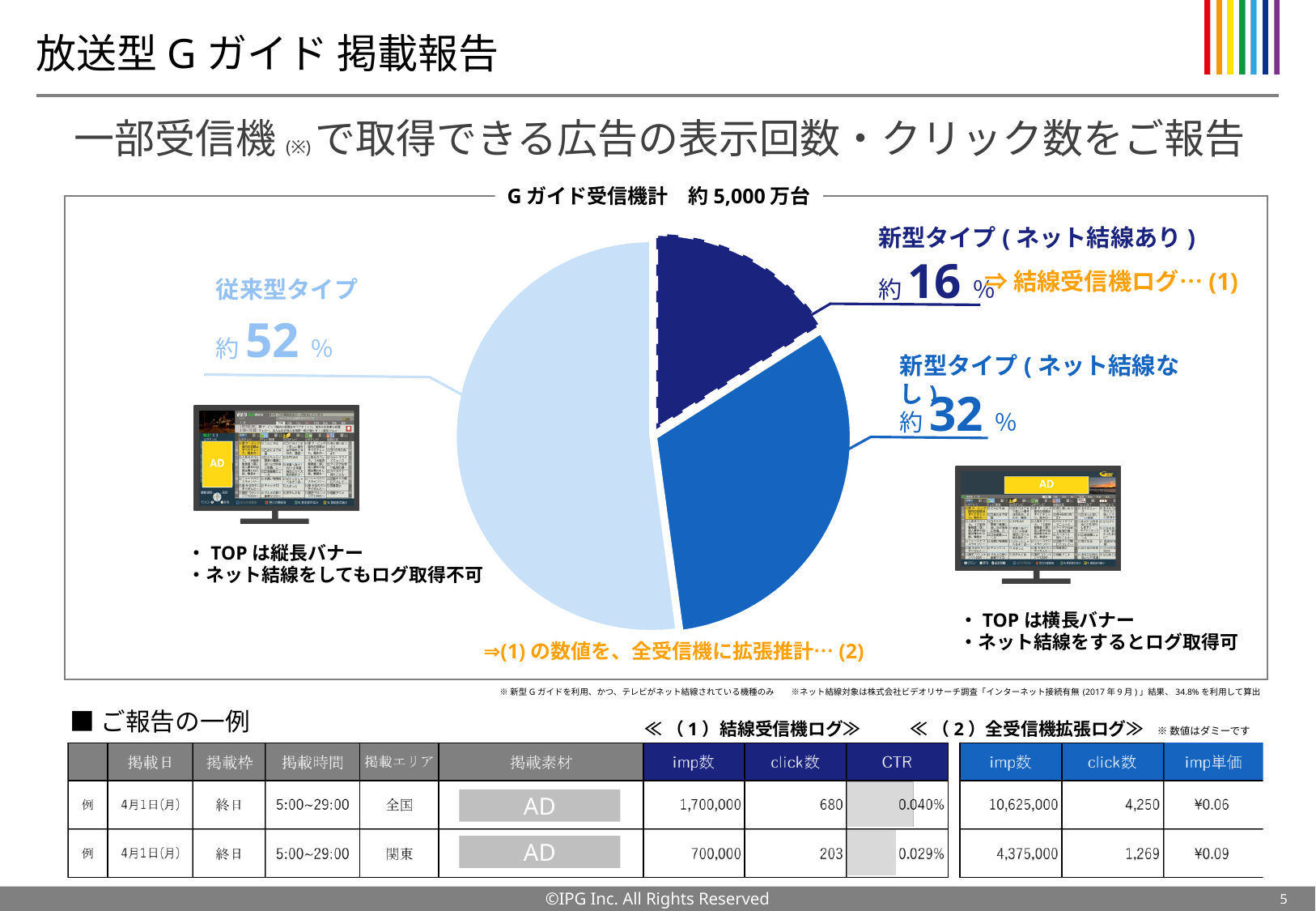
What kind of chart is shown on the slide? pie chart Which is larger, the share for 新型タイプ(ネット結線なし) or the share for 新型タイプ(ネット結線あり)? 新型タイプ(ネット結線なし) Which slice of the pie chart is drawn in the lightest blue? 従来型タイプ What share of the pie does 新型タイプ(ネット結線なし) account for? 約32% What share of the pie does 新型タイプ(ネット結線あり) account for? 約16% What is the total number of G guide receivers stated above the pie chart? 約5,000万台 How many slices does the pie chart have? 3 By how many percentage points does the 従来型タイプ share exceed the 新型タイプ(ネット結線あり) share? 36 Which slice of the pie chart is the smallest? 新型タイプ(ネット結線あり) Which slice of the pie chart is the largest? 従来型タイプ What share of the pie does 従来型タイプ account for? 約52%